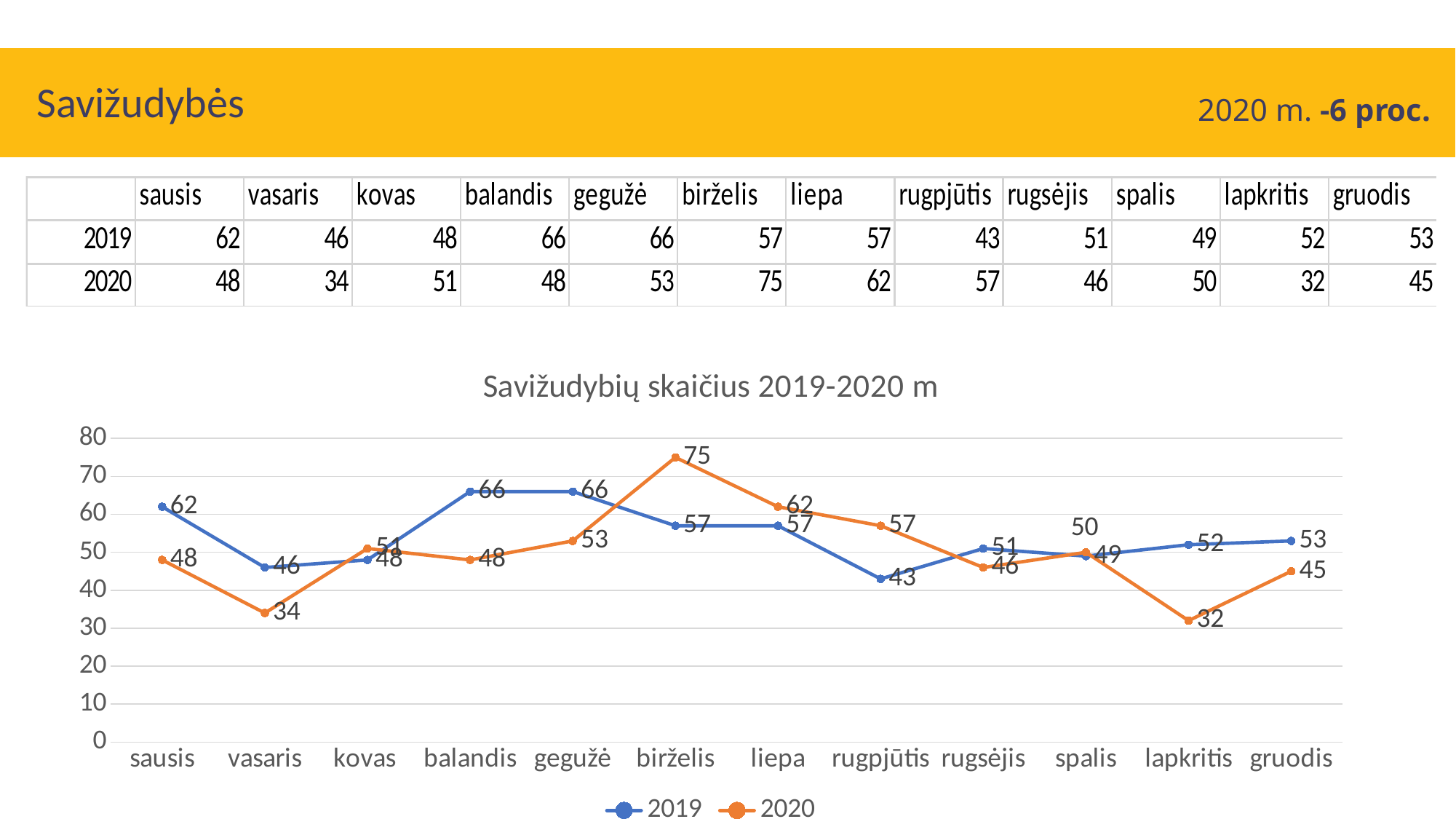
What kind of chart is shown? line chart How many months are shown on the x axis? 12 What is the value for 2020 in birželis? 75 What is the value for 2019 in rugpjūtis? 43 Which month has the highest value for the 2020 series? birželis Which series has the larger value in sausis, 2019 or 2020? 2019 How many series does the legend list? 2 Which month has the lowest value for the 2019 series? rugpjūtis What is the title of the chart? Savižudybių skaičius 2019-2020 m Which month has the lowest value for the 2020 series? lapkritis What is the value for 2020 in lapkritis? 32 What is the difference between the 2020 and 2019 values in birželis? 18